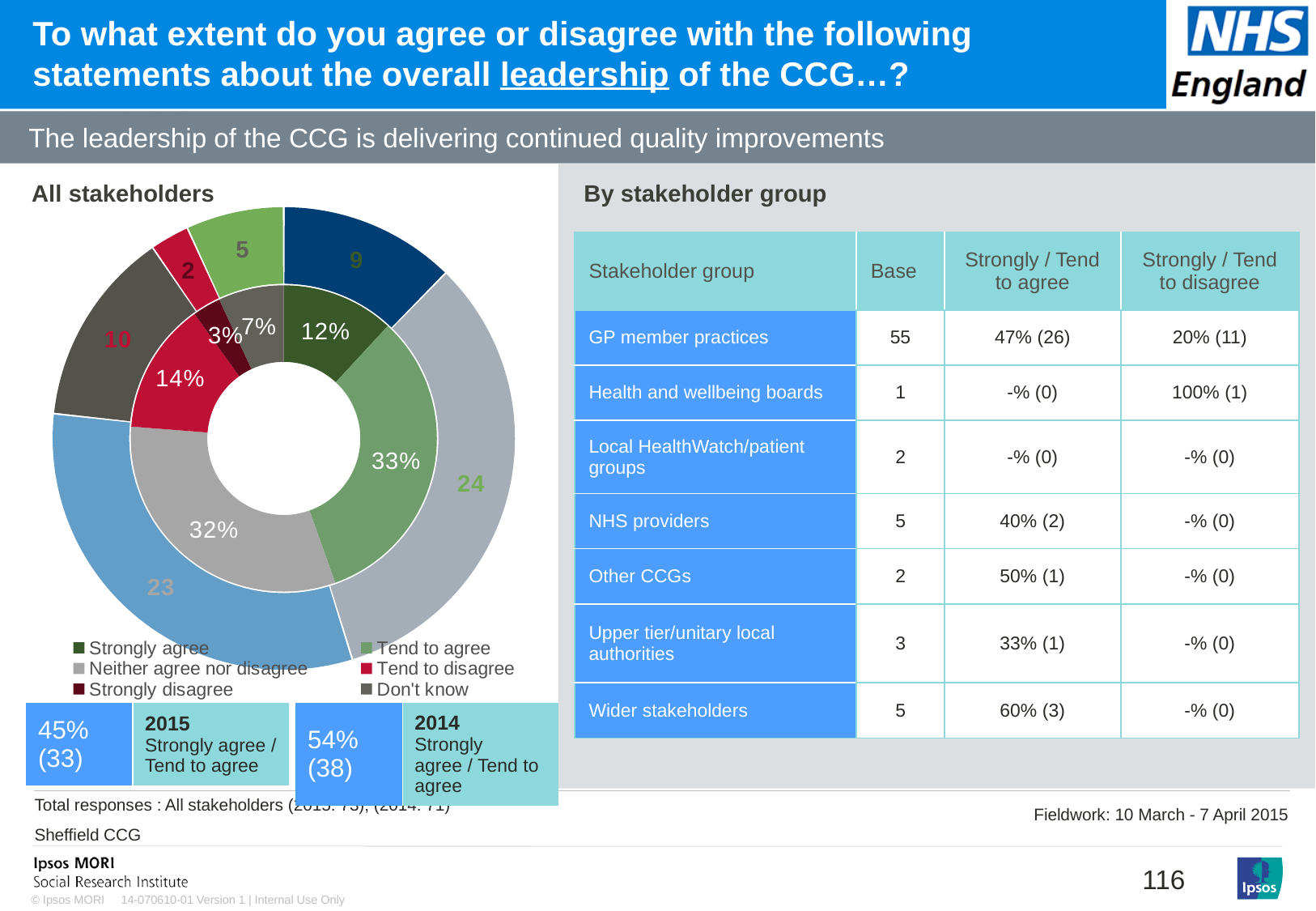
In the 'All stakeholders' chart, what percentage of respondents 'Tend to agree'? 33% In the 'All stakeholders' chart, what percentage answered 'Don't know'? 7% In the 'All stakeholders' chart, what percentage 'Neither agree nor disagree'? 32% How many response categories does the legend of the 'All stakeholders' chart list? 6 In the 'All stakeholders' chart, what is the difference in percentage points between 'Tend to agree' and 'Strongly agree'? 21 percentage points In the 'All stakeholders' chart, what percentage 'Tend to disagree'? 14% In the 'All stakeholders' chart, what is the combined percentage of 'Strongly agree' and 'Tend to agree'? 45% What kind of chart is shown under 'All stakeholders'? Doughnut (pie) chart In the 'All stakeholders' chart, which response category has the smallest share? Strongly disagree In the 'All stakeholders' chart, what percentage 'Strongly agree'? 12% In the 'All stakeholders' chart, which is larger: 'Tend to disagree' or 'Don't know'? Tend to disagree In the 'All stakeholders' chart, which response category has the largest share? Tend to agree